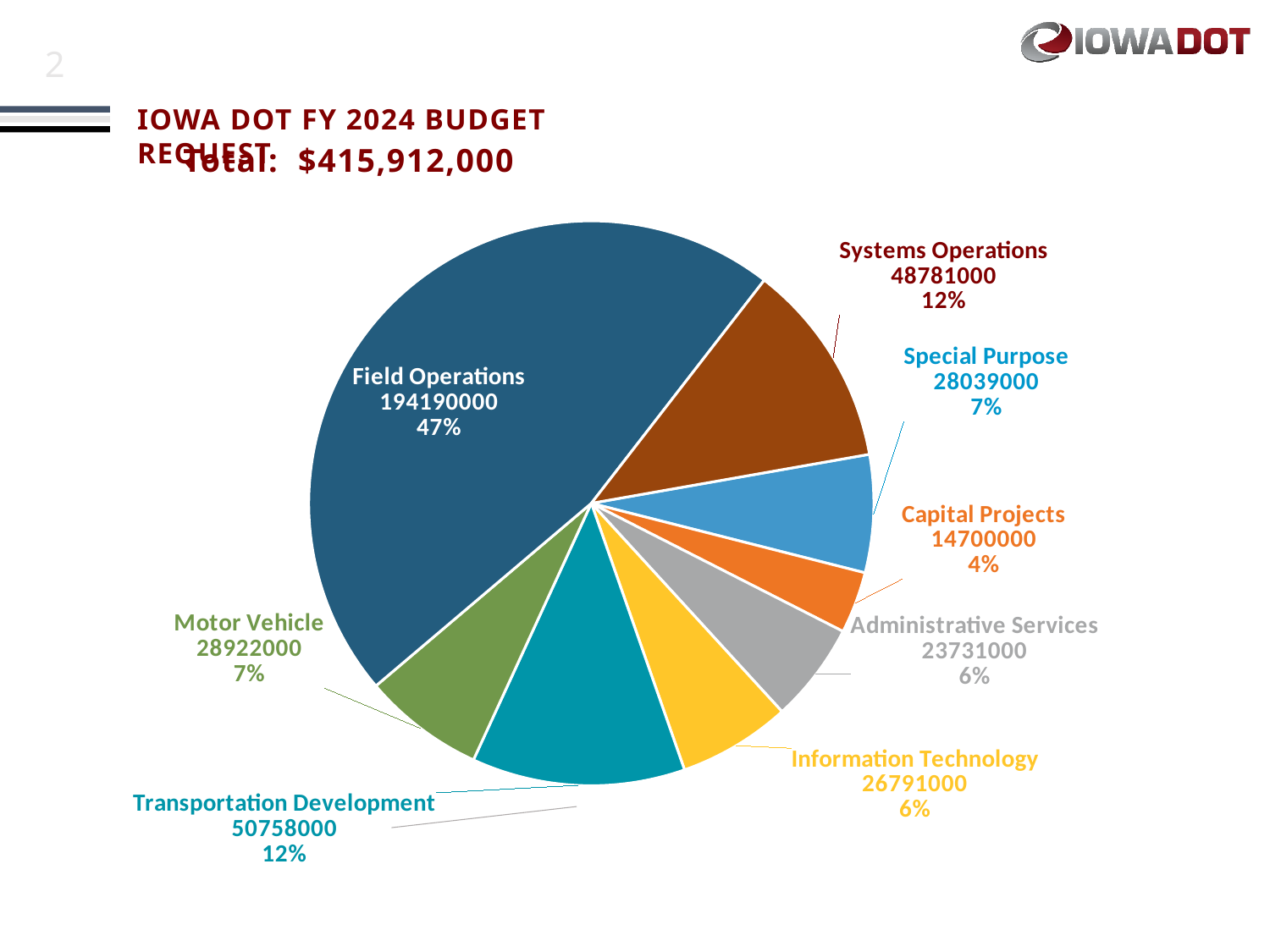
What share of the pie does Administrative Services represent? 6% What is the difference between the values for Transportation Development and Systems Operations? 1977000 Which category has the largest slice of the pie? Field Operations What is the difference between the values for Motor Vehicle and Special Purpose? 883000 Which category has the smallest slice of the pie? Capital Projects What is the value for Field Operations? 194190000 What total amount is stated above the pie chart? $415,912,000 What share of the pie does Transportation Development represent? 12% How many categories are shown in the pie chart? 8 What type of chart is shown on the slide? Pie chart Which is larger, the value for Information Technology or the value for Administrative Services? Information Technology What is the value for Capital Projects? 14700000